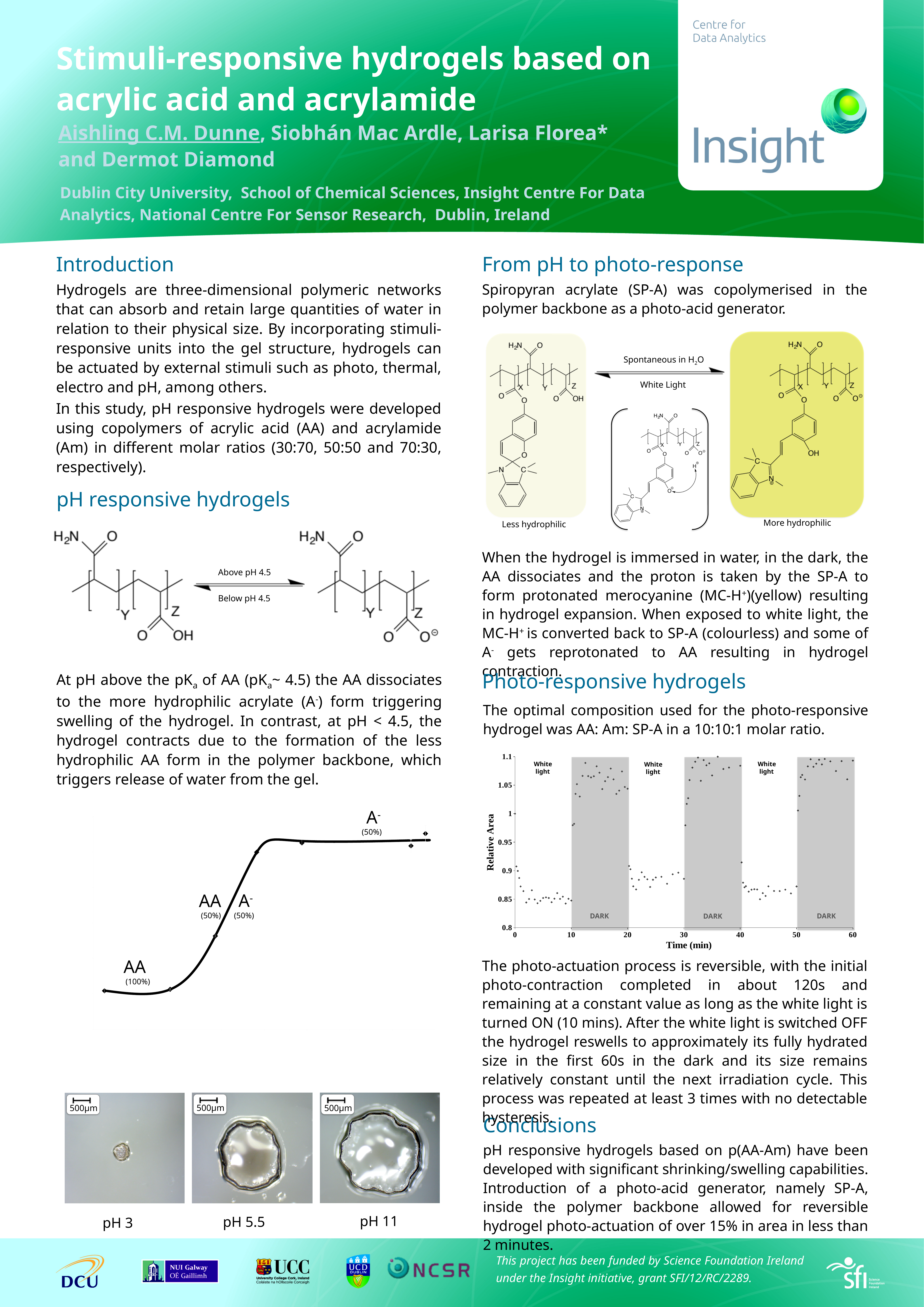
In the Relative Area chart, what is the label of the y axis? Relative Area In the Relative Area chart, is the relative area higher during the DARK periods or during the white light periods? DARK periods In the Relative Area chart, is the relative area during the third DARK period (50 to 60 min) greater or less than 1? greater In the Relative Area chart, how many shaded DARK periods are shown? 3 What kind of chart is the AA / A- curve on the left side of the slide? line chart In the Relative Area chart, what is the label of the x axis? Time (min) In the Relative Area chart, is the relative area during the second white light period (20 to 30 min) greater or less than 1? less In the AA / A- curve chart on the left, does the curve rise or fall from left to right? rise In the Relative Area chart, is the relative area during the first white light period (0 to 10 min) greater or less than 0.95? less What kind of chart is the Relative Area versus Time chart on the right side of the slide? scatter chart In the Relative Area chart, what is the highest value shown on the x axis? 60